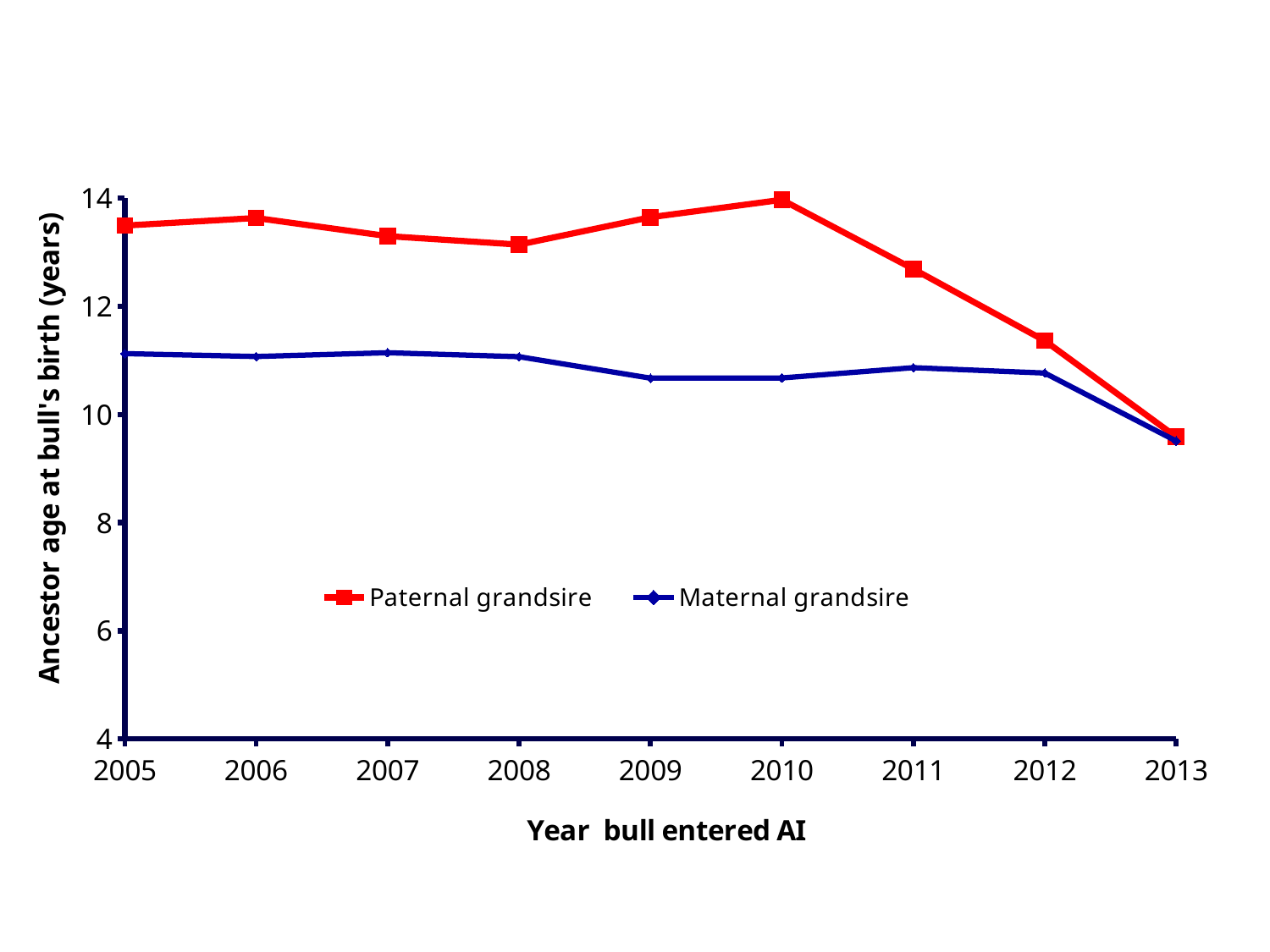
Is the Paternal grandsire value for 2012 greater or less than 12? less In which year is the Paternal grandsire value lowest? 2013 What is the title of the x axis? Year bull entered AI What kind of chart is shown on the slide? line chart How many years are plotted along the x axis? 9 In which year is the Maternal grandsire value lowest? 2013 Is the Paternal grandsire value for 2011 greater or less than 12? greater In which year is the Paternal grandsire value highest? 2010 In 2010, which series has the larger value, Paternal grandsire or Maternal grandsire? Paternal grandsire How many series does the legend list? 2 Is the Maternal grandsire value for 2013 greater or less than 10? less Does the Paternal grandsire line rise or fall from 2010 to 2013? fall